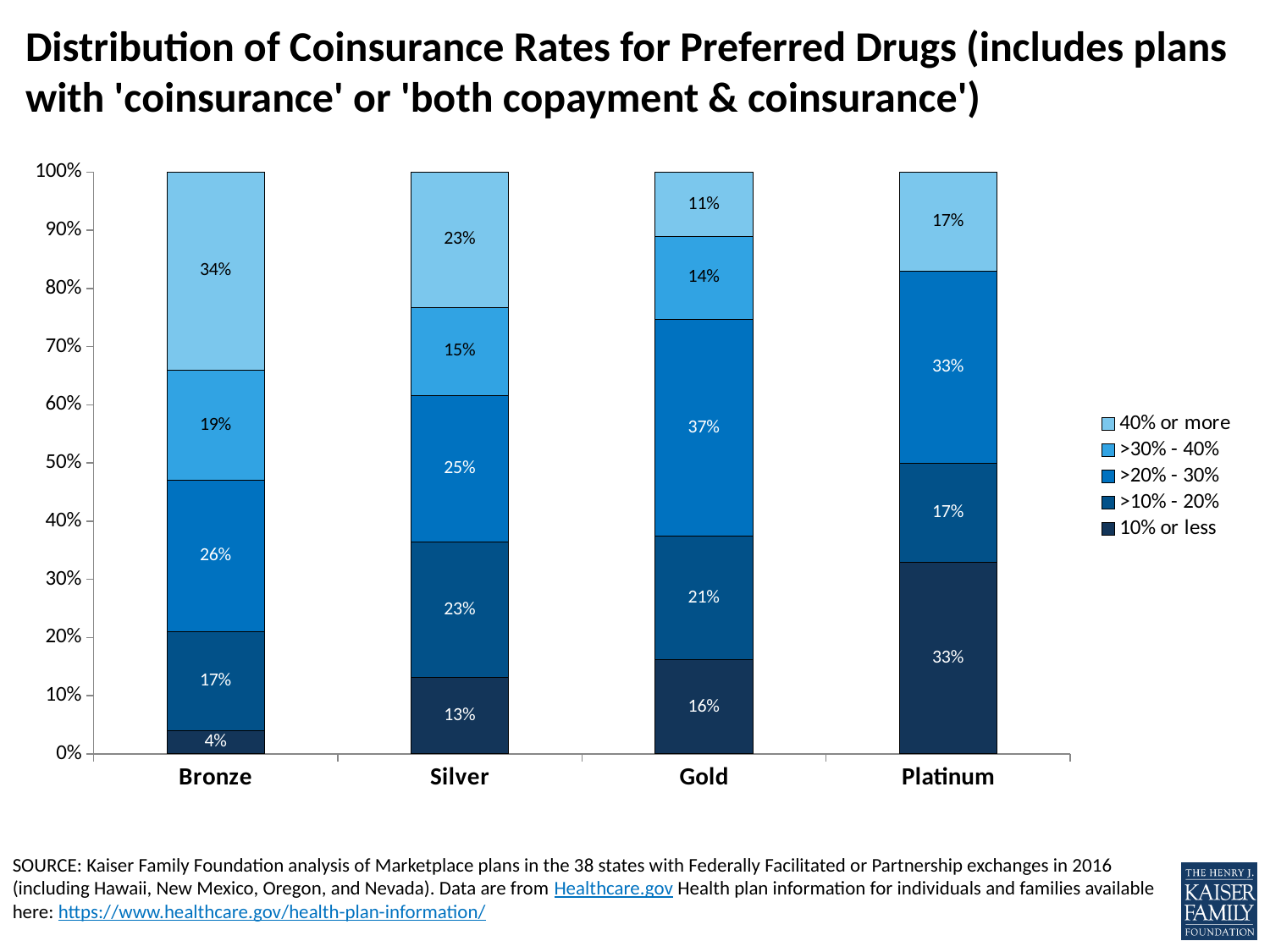
What share of Platinum plans have a coinsurance rate of 40% or more? 17% What kind of chart is shown on the slide? Stacked bar chart What share of Gold plans fall in the >20% - 30% coinsurance range? 37% Which plan type has the largest share of plans with coinsurance of 10% or less? Platinum Which legend entry is listed first (at the top of the legend)? 40% or more What share of Bronze plans have a coinsurance rate of 40% or more? 34% Which plan type has the smallest share of plans with coinsurance of 10% or less? Bronze How many percentage points larger is the '40% or more' share for Bronze than for Gold? 23 percentage points Which has a larger '>20% - 30%' share, Silver or Gold? Gold What share of Silver plans have a coinsurance rate of 10% or less? 13% How many plan categories are shown on the x axis? 4 How many series does the legend list? 5